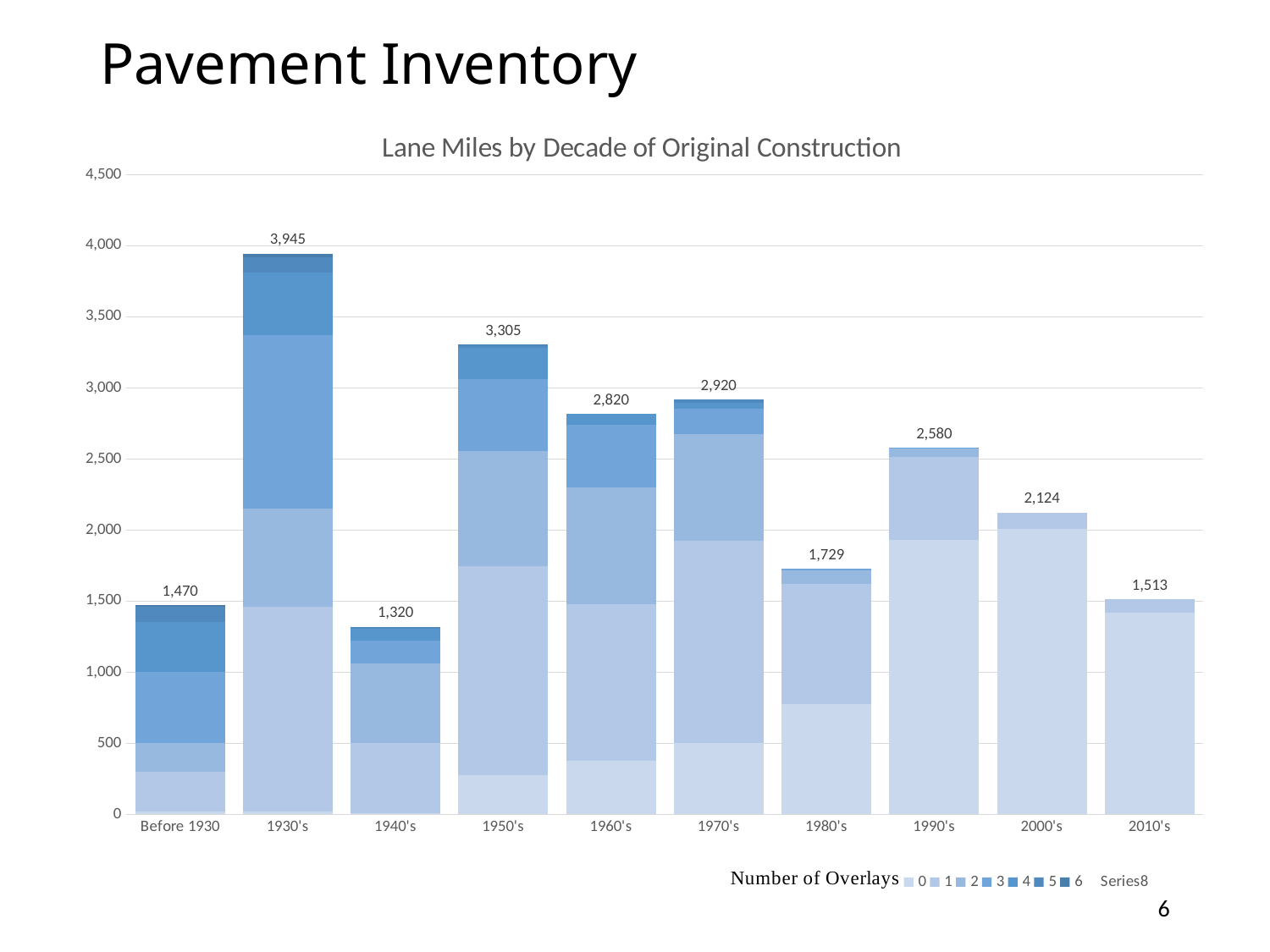
What is the total lane miles labeled for the 1930's bar? 3,945 What is the difference between the total lane miles for the 1970's and the 1960's? 100 How many decade categories are shown on the x axis? 10 Which has more total lane miles, the 2000's or the 2010's? 2000's What is the total lane miles labeled for the 1990's bar? 2,580 What kind of chart is shown on the slide? Stacked bar chart How many entries does the legend list? 8 Which decade has the highest total lane miles? 1930's What is the total lane miles labeled for the Before 1930 bar? 1,470 Which decade has the lowest total lane miles? 1940's What is the title of the chart? Lane Miles by Decade of Original Construction What is the difference between the total lane miles for the 1930's and the 1950's? 640